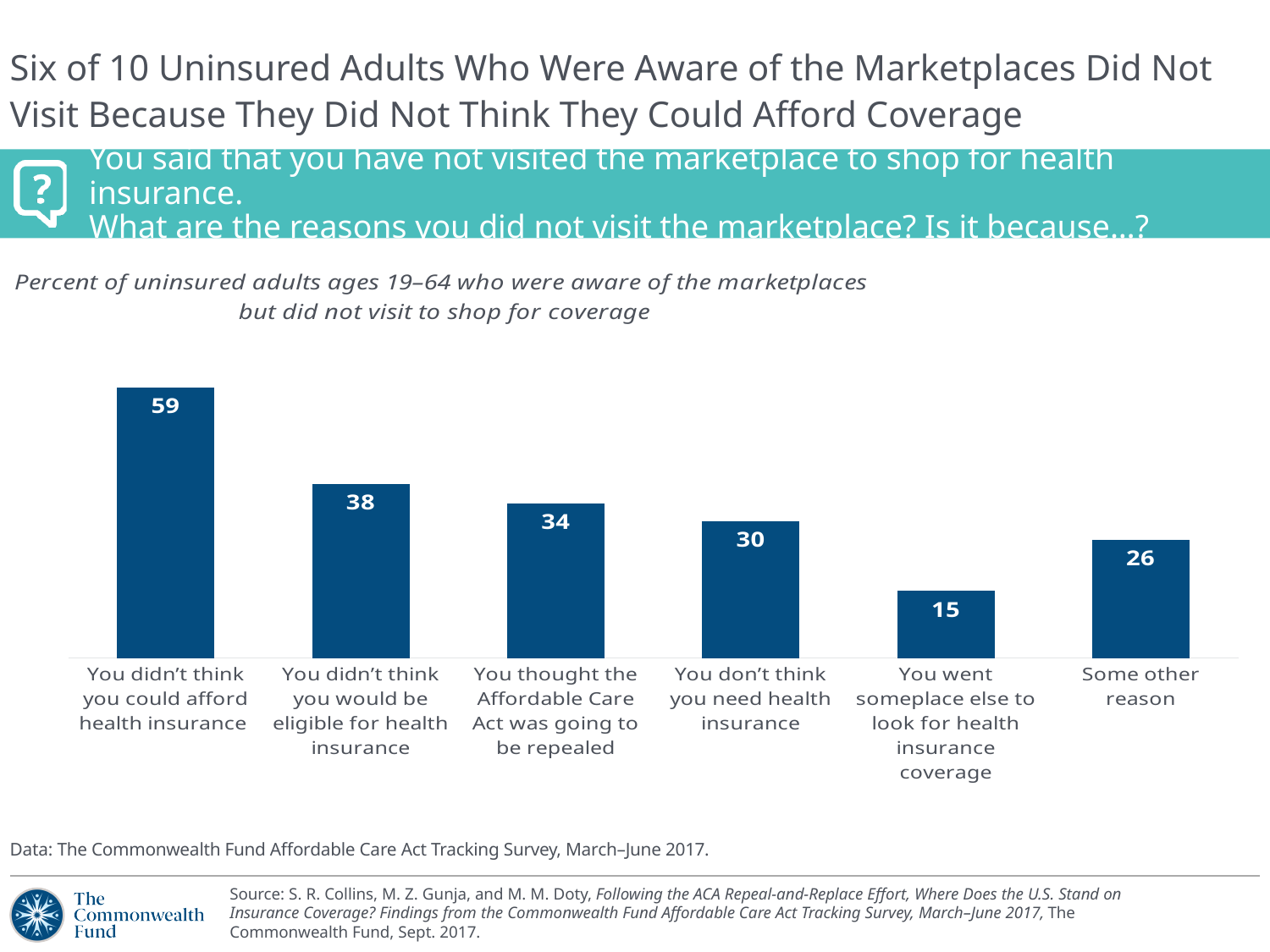
What is the value for 'You thought the Affordable Care Act was going to be repealed'? 34 What kind of chart is shown on the slide? Bar chart Which reason has the lowest value in the chart? You went someplace else to look for health insurance coverage What is the value for 'Some other reason'? 26 What is the difference between the value for 'You thought the Affordable Care Act was going to be repealed' and the value for 'You went someplace else to look for health insurance coverage'? 19 What percent of uninsured adults who were aware of the marketplaces but did not visit said they didn't think they could afford health insurance? 59 What is the difference between the value for 'You didn't think you could afford health insurance' and the value for 'You didn't think you would be eligible for health insurance'? 21 Which reason has the highest value in the chart? You didn't think you could afford health insurance How many reasons (categories) are shown in the chart? 6 What is the data source cited below the chart? The Commonwealth Fund Affordable Care Act Tracking Survey, March–June 2017 Which is larger: the value for 'You don't think you need health insurance' or the value for 'Some other reason'? You don't think you need health insurance What is the value for 'You went someplace else to look for health insurance coverage'? 15